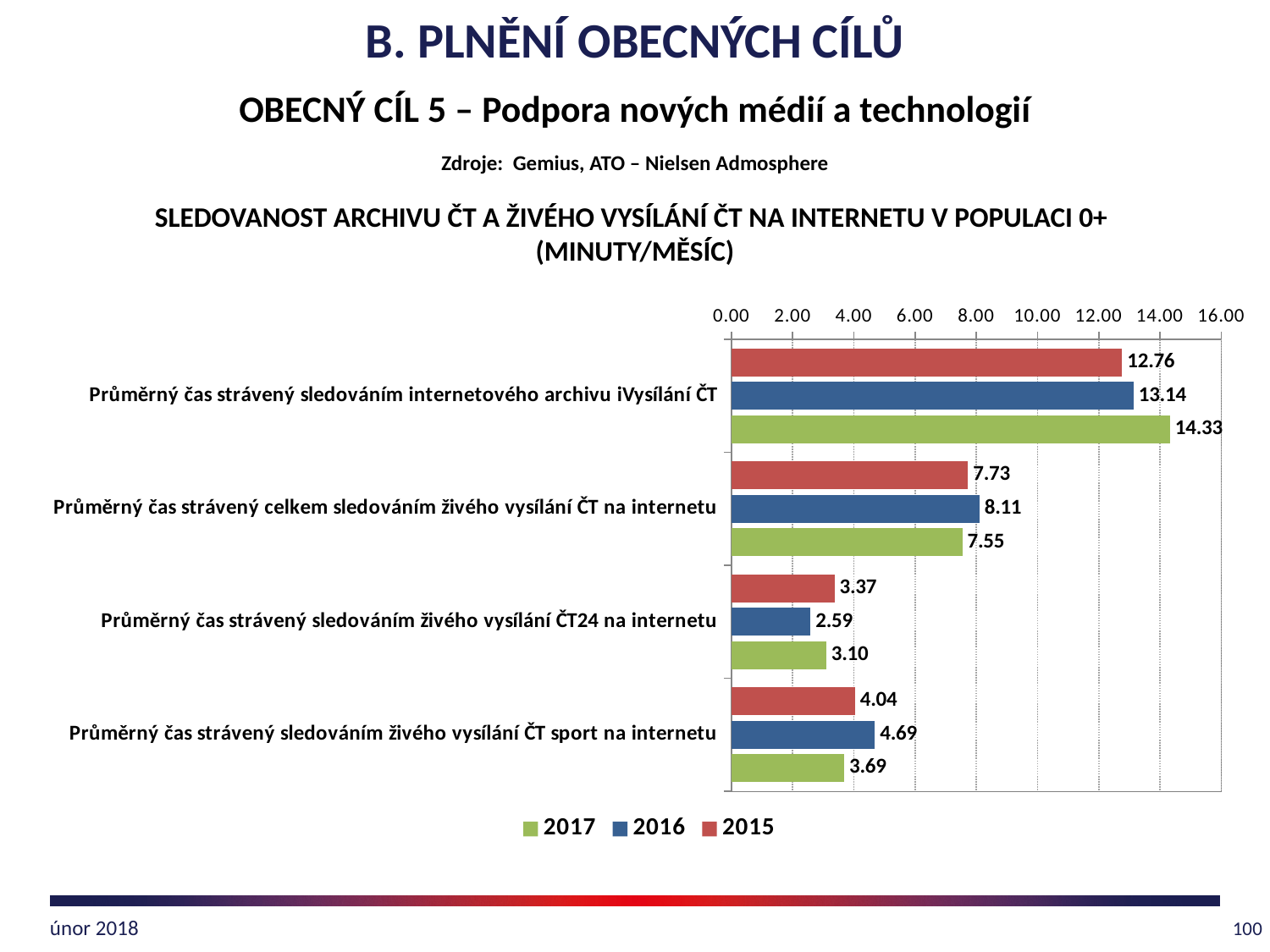
What is the difference between the 2017 and 2015 values for 'Průměrný čas strávený sledováním internetového archivu iVysílání ČT'? 1.57 What is the 2016 value for 'Průměrný čas strávený sledováním živého vysílání ČT24 na internetu'? 2.59 How many series does the legend list? 3 What kind of chart is shown on the slide? bar chart What is the 2015 value for 'Průměrný čas strávený sledováním živého vysílání ČT sport na internetu'? 4.04 Which category has the lowest 2016 value? Průměrný čas strávený sledováním živého vysílání ČT24 na internetu What is the 2017 value for 'Průměrný čas strávený sledováním internetového archivu iVysílání ČT'? 14.33 For 'Průměrný čas strávený celkem sledováním živého vysílání ČT na internetu', which year has the larger value, 2016 or 2017? 2016 Which colour represents the 2017 series in the legend? green Is the 2016 value for 'Průměrný čas strávený sledováním internetového archivu iVysílání ČT' greater or less than 12.00? greater Which category has the highest 2017 value? Průměrný čas strávený sledováním internetového archivu iVysílání ČT How many categories are shown on the chart? 4